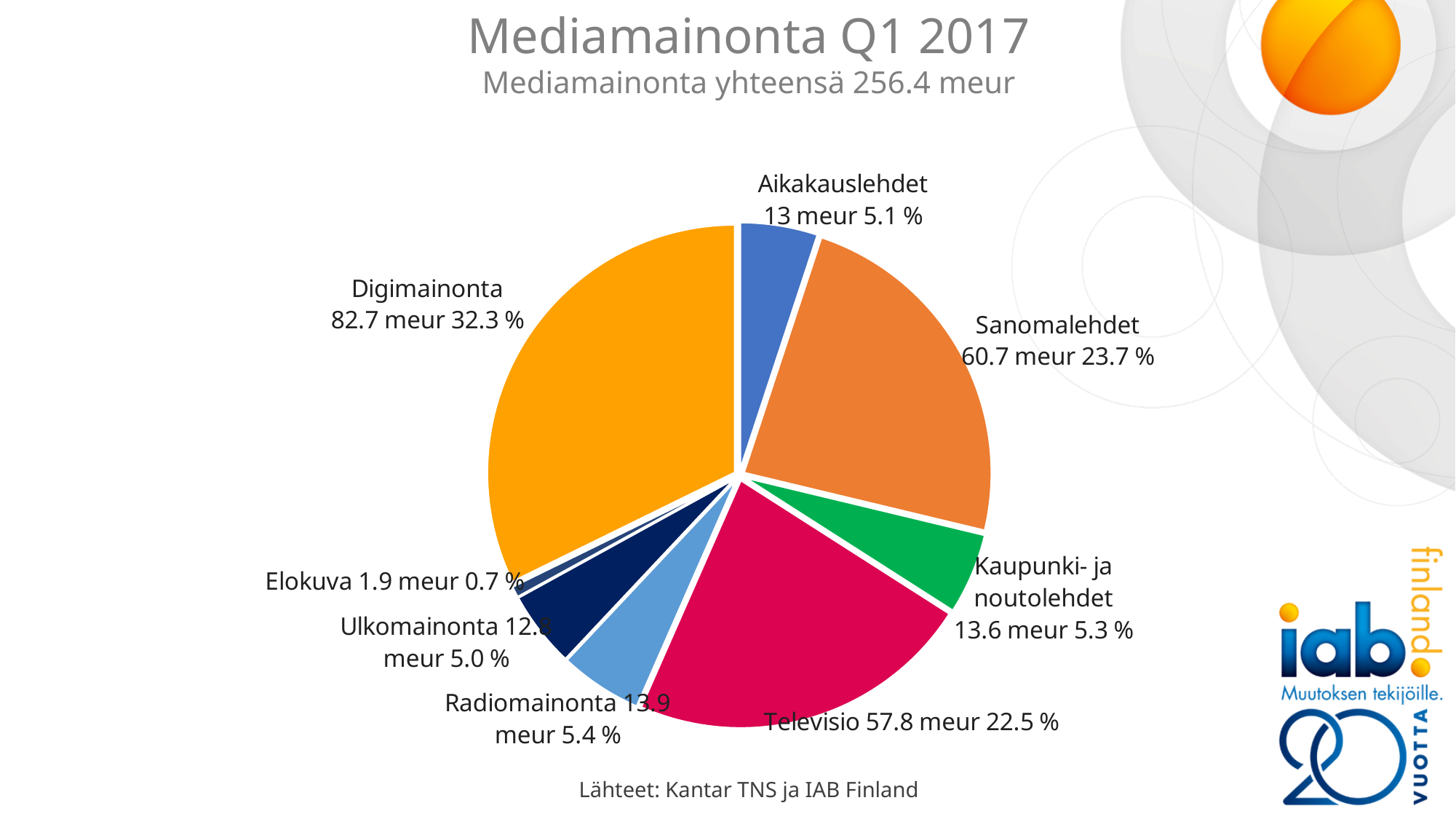
Which category has the largest slice? Digimainonta What is the total media advertising stated in the subtitle? 256.4 meur What is the title of the chart? Mediamainonta Q1 2017 What kind of chart is shown on the slide? pie chart What share of the pie does Kaupunki- ja noutolehdet have? 5.3 % What is the value for Digimainonta? 82.7 meur Which category has the smallest slice? Elokuva What is the difference in meur between Digimainonta and Sanomalehdet? 22 meur What is the value for Televisio? 57.8 meur How many slices does the pie chart have? 8 Which is larger, Radiomainonta or Ulkomainonta? Radiomainonta What share of the pie does Sanomalehdet have? 23.7 %